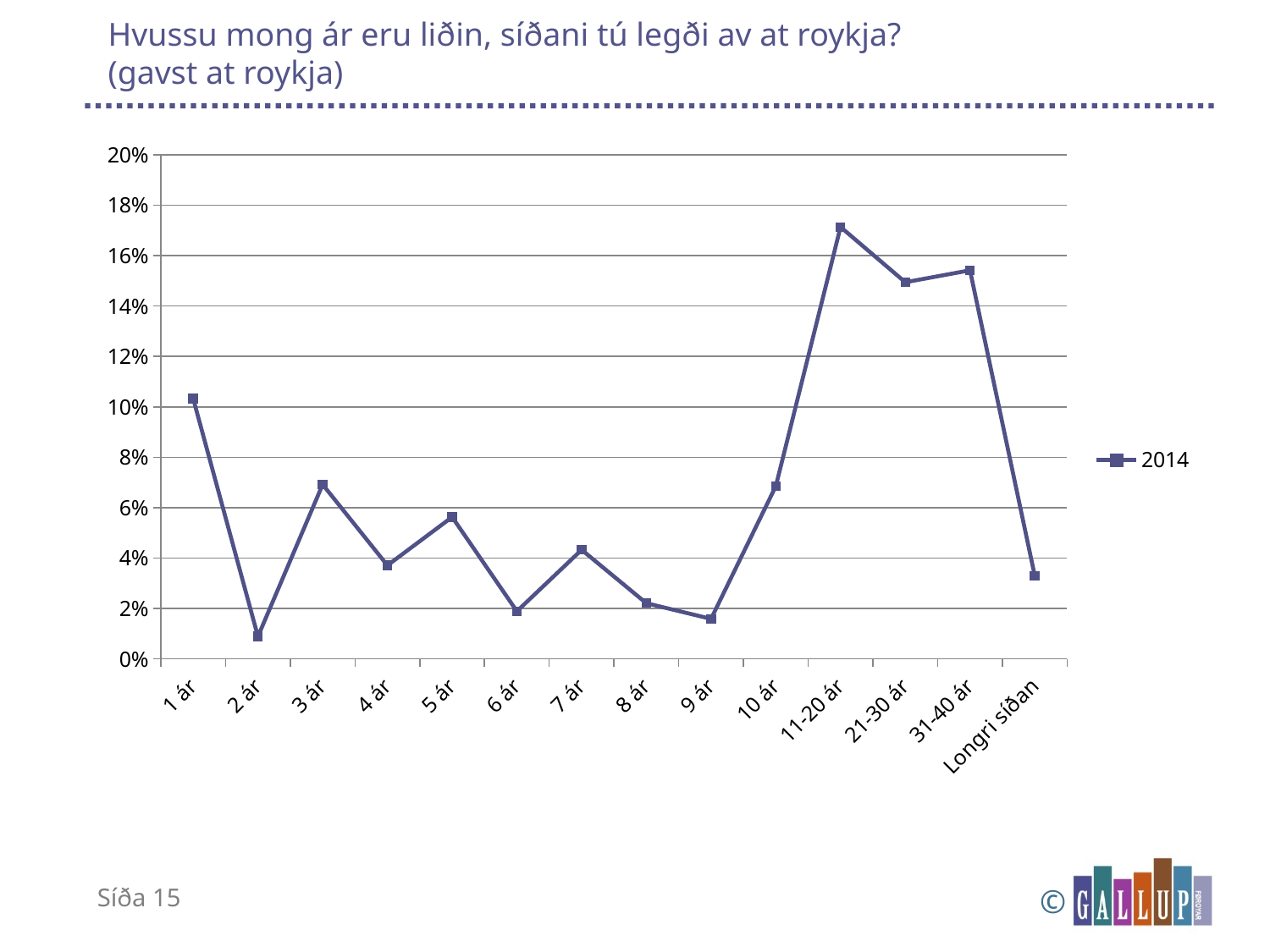
How many categories are shown on the x axis? 14 What series name is shown in the legend? 2014 Which is larger, the value for 3 ár or the value for 5 ár? 3 ár Which category has the lowest value? 2 ár Is the value for 11-20 ár greater or less than 16%? greater What kind of chart is shown on the slide? line chart Is the value for 1 ár greater or less than 8%? greater Do the values rise or fall from 9 ár to 11-20 ár? rise Which category has the highest value? 11-20 ár How many series does the legend list? 1 Is the value for Longri síðan greater or less than 4%? less